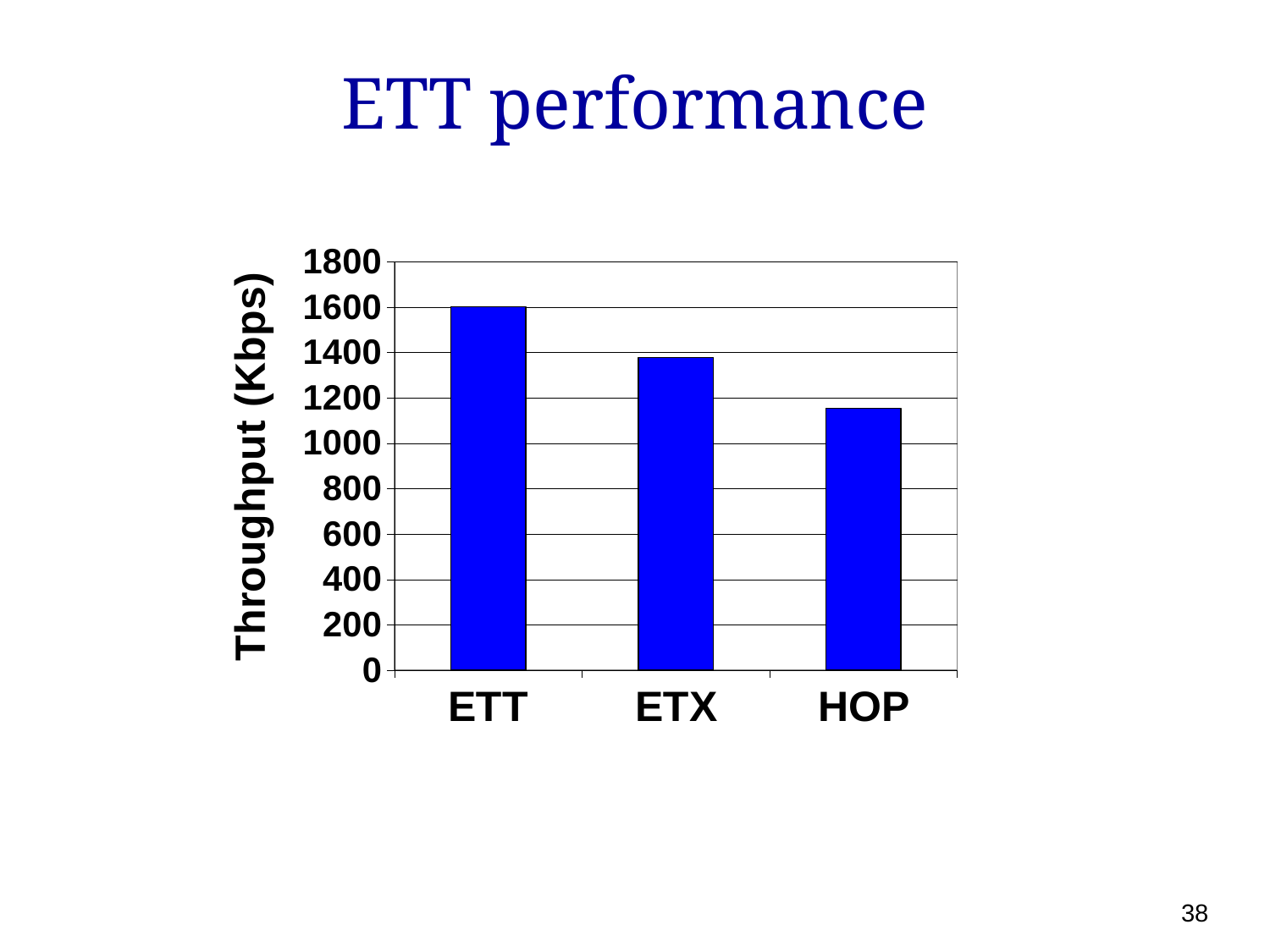
What is the label on the y axis? Throughput (Kbps) What kind of chart is shown on the slide? bar chart What is the title of the slide? ETT performance Which has the larger throughput, ETX or HOP? ETX Is the value for ETX greater or less than 1200? greater Do the bar values rise or fall from left to right along the x axis? fall How many categories are plotted on the x axis? 3 Is the value for HOP greater or less than 1200? less Is the value for ETT greater or less than 1400? greater Which category has the highest throughput? ETT Which category has the lowest throughput? HOP